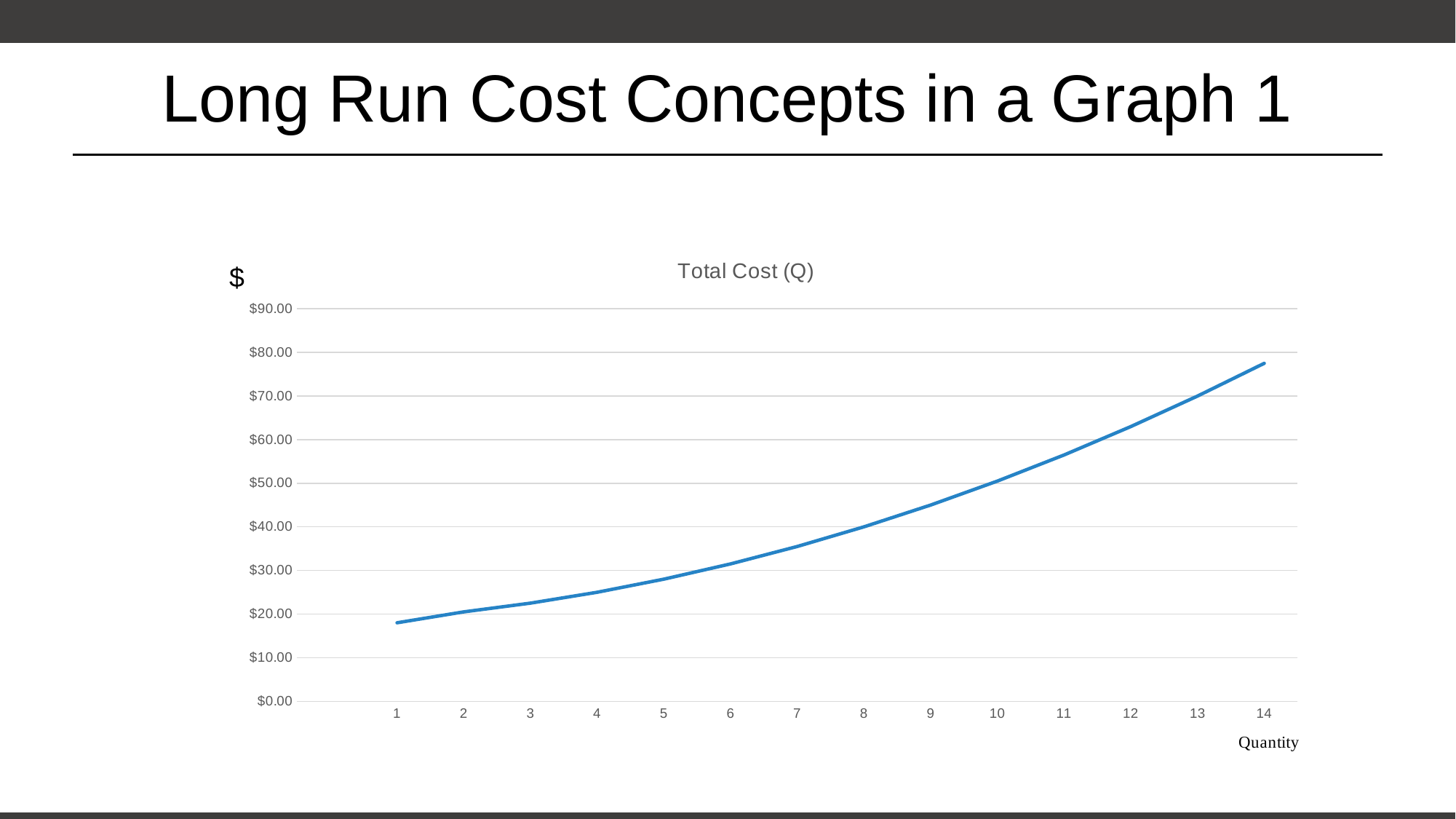
How many quantity points are plotted on the x axis? 14 Is the total cost at quantity 11 greater or less than $50.00? greater What kind of chart is shown on the slide? line chart At which quantity is total cost highest? 14 What is the title of the chart? Total Cost (Q) At which quantity is total cost lowest? 1 Does total cost rise or fall as quantity increases from 1 to 14? rise What label is shown on the x axis of the chart? Quantity Which has the larger total cost, quantity 5 or quantity 12? quantity 12 Is the total cost at quantity 8 greater or less than $50.00? less Is the total cost at quantity 14 greater or less than $70.00? greater